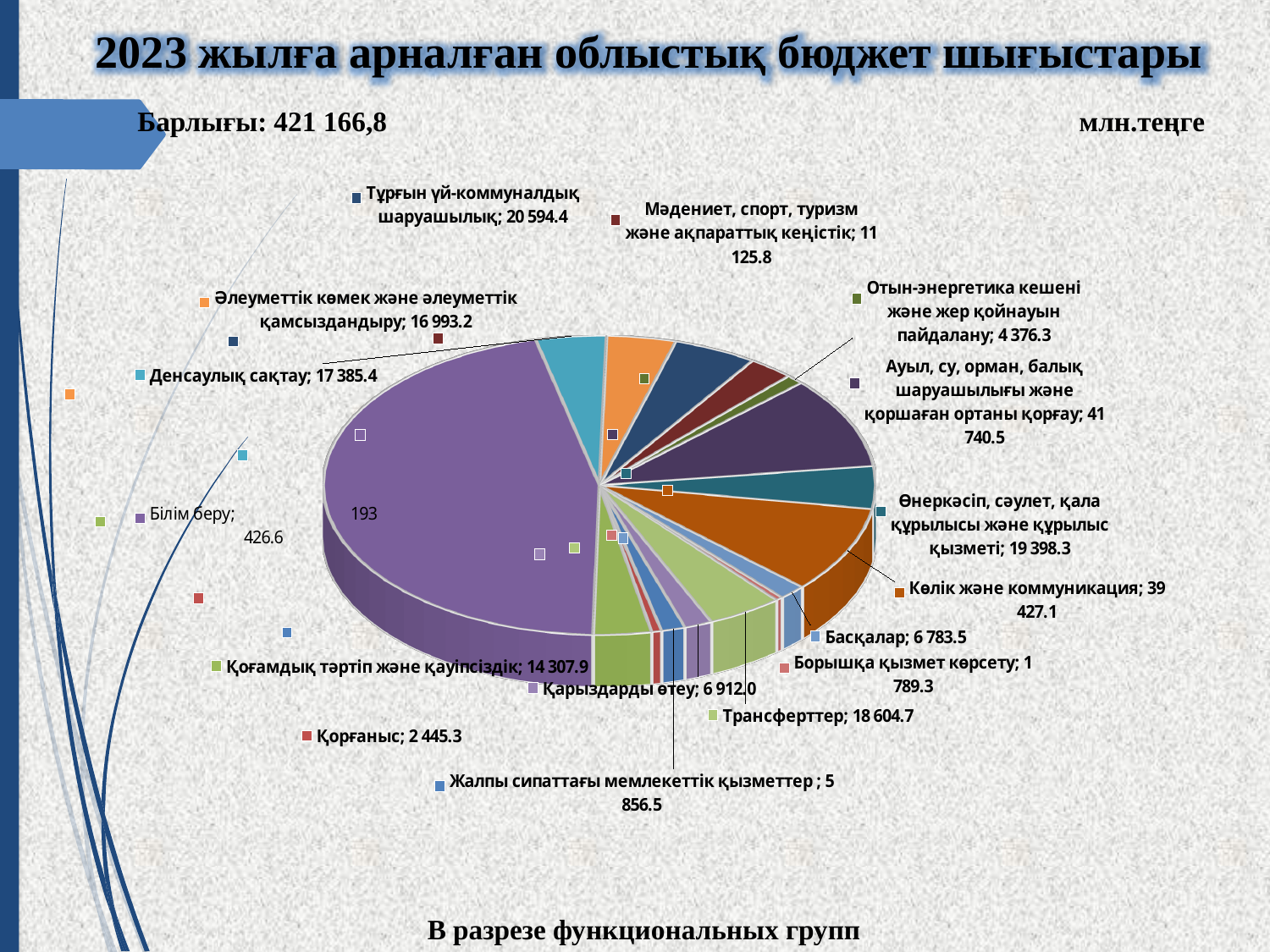
What is the value for Трансферттер? 18 604.7 What is the value for Білім беру? 193 426.6 How many categories are shown in the pie chart? 16 What is the difference between Ауыл, су, орман, балық шаруашылығы және қоршаған ортаны қорғау and Көлік және коммуникация? 2 313.4 What is the value for Денсаулық сақтау? 17 385.4 Which category has the smallest value in the pie chart? Борышқа қызмет көрсету Which is larger: Тұрғын үй-коммуналдық шаруашылық or Өнеркәсіп, сәулет, қала құрылысы және құрылыс қызметі? Тұрғын үй-коммуналдық шаруашылық What total value (Барлығы) is stated on the slide? 421 166,8 In what units are the values on the slide expressed? млн.теңге What type of chart is shown on the slide? Pie chart What is the value for Көлік және коммуникация? 39 427.1 Which category has the largest value in the pie chart? Білім беру